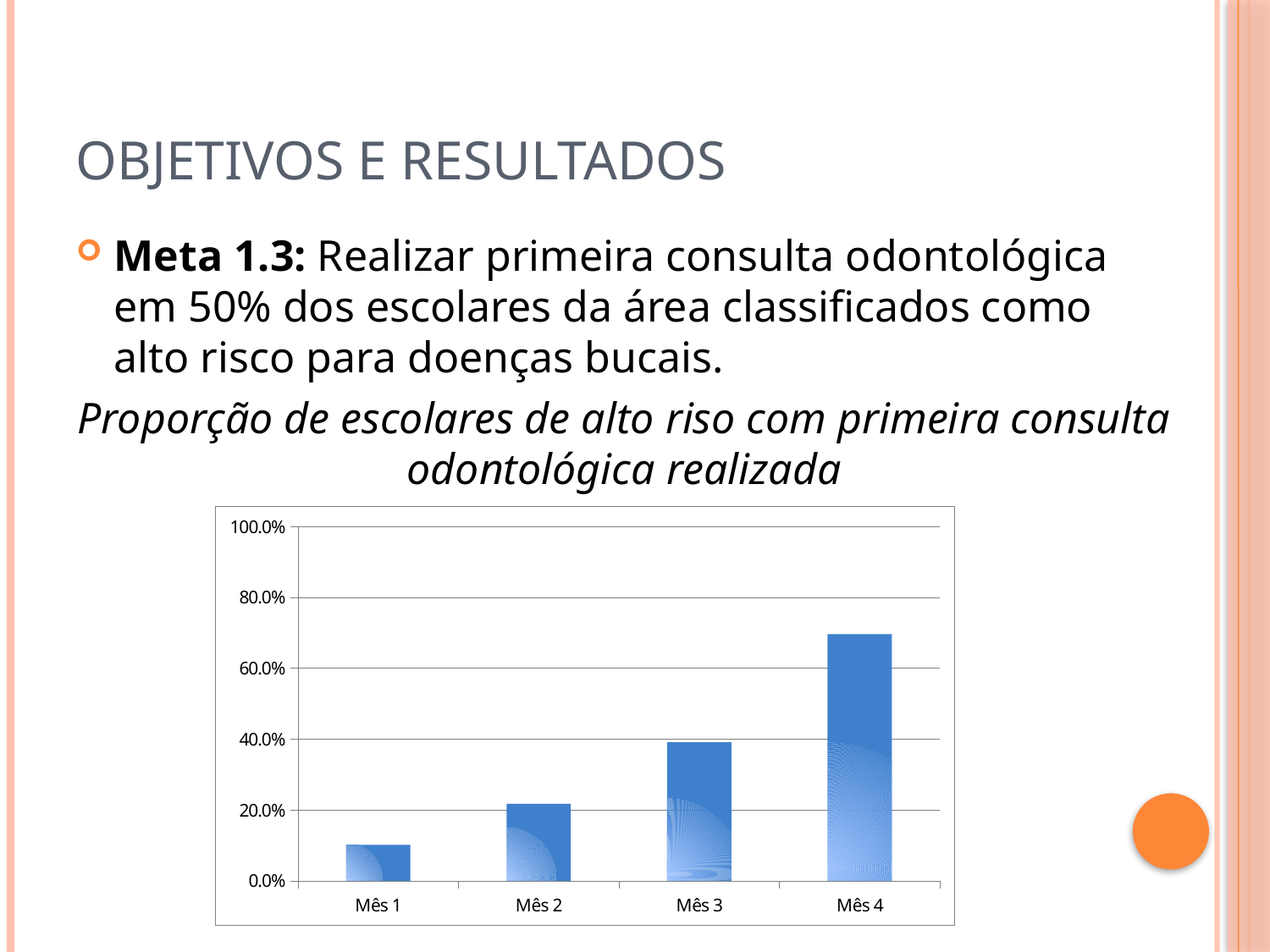
Is the value for Mês 3 greater or less than 20.0%? greater Is the value for Mês 4 greater or less than 80.0%? less Is the value for Mês 2 greater or less than 40.0%? less What kind of chart is shown on the slide? bar chart Which is larger, the value for Mês 2 or the value for Mês 3? Mês 3 Which month has the lowest value on the chart? Mês 1 How many categories (months) are plotted on the chart? 4 Which month has the highest proportion of high-risk schoolchildren with a first dental consultation? Mês 4 Do the values rise or fall from Mês 1 to Mês 4? rise What is the title of the chart? Proporção de escolares de alto riso com primeira consulta odontológica realizada